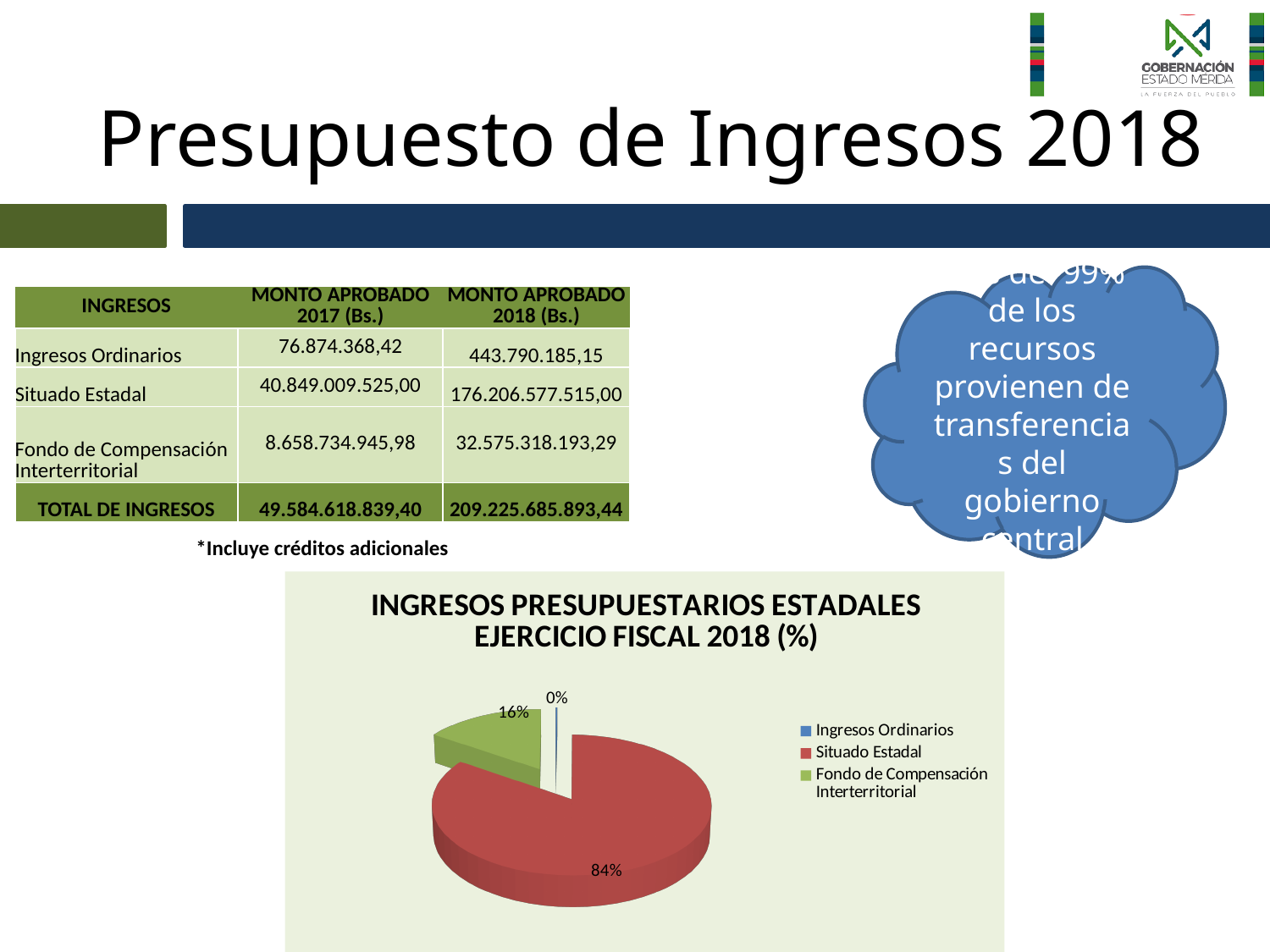
What is the difference in percentage points between Situado Estadal and Fondo de Compensación Interterritorial? 68 Which is larger, the share for Fondo de Compensación Interterritorial or the share for Ingresos Ordinarios? Fondo de Compensación Interterritorial What type of chart is shown on the slide? pie chart What colour is the Situado Estadal slice in the pie chart? red Which category has the largest share of the pie? Situado Estadal What share of the pie does Situado Estadal take? 84% What percentage does the Fondo de Compensación Interterritorial slice represent? 16% Which category has the smallest share of the pie? Ingresos Ordinarios How many slices does the pie chart have? 3 What percentage does the Ingresos Ordinarios slice represent? 0% What percentage does the Situado Estadal slice represent? 84% What is the title of the chart? INGRESOS PRESUPUESTARIOS ESTADALES EJERCICIO FISCAL 2018 (%)